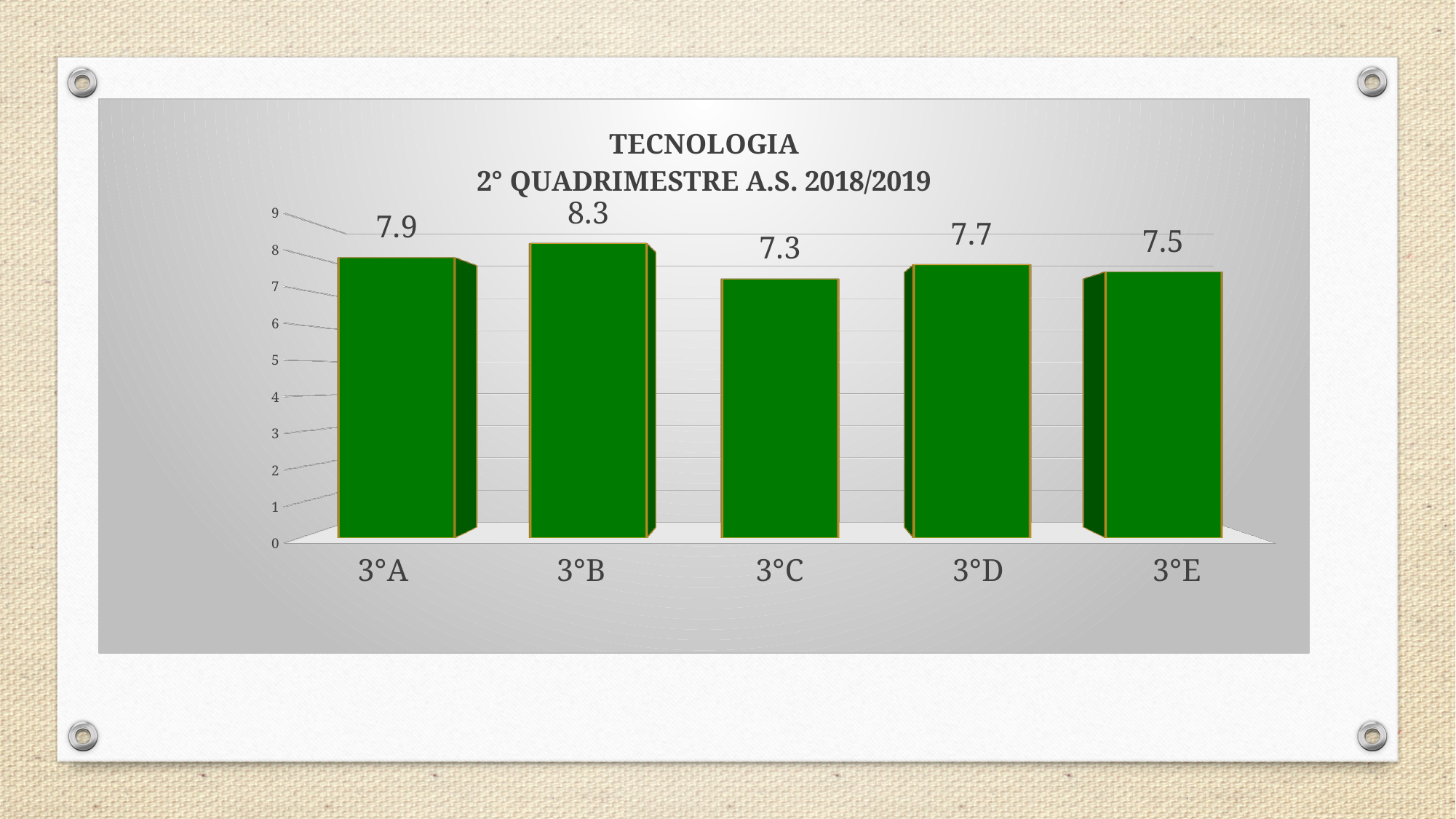
What is the title of the chart? TECNOLOGIA 2° QUADRIMESTRE A.S. 2018/2019 What is the value for 3°E? 7.5 How many classes are shown on the x axis? 5 What is the value for 3°A? 7.9 What is the difference between the values for 3°B and 3°C? 1 What is the difference between the values for 3°A and 3°D? 0.2 Which class has the highest value? 3°B Which is larger, the value for 3°D or the value for 3°E? 3°D What kind of chart is this? bar chart Which class has the lowest value? 3°C Is the value for 3°B greater or less than 8? greater What is the value for 3°C? 7.3